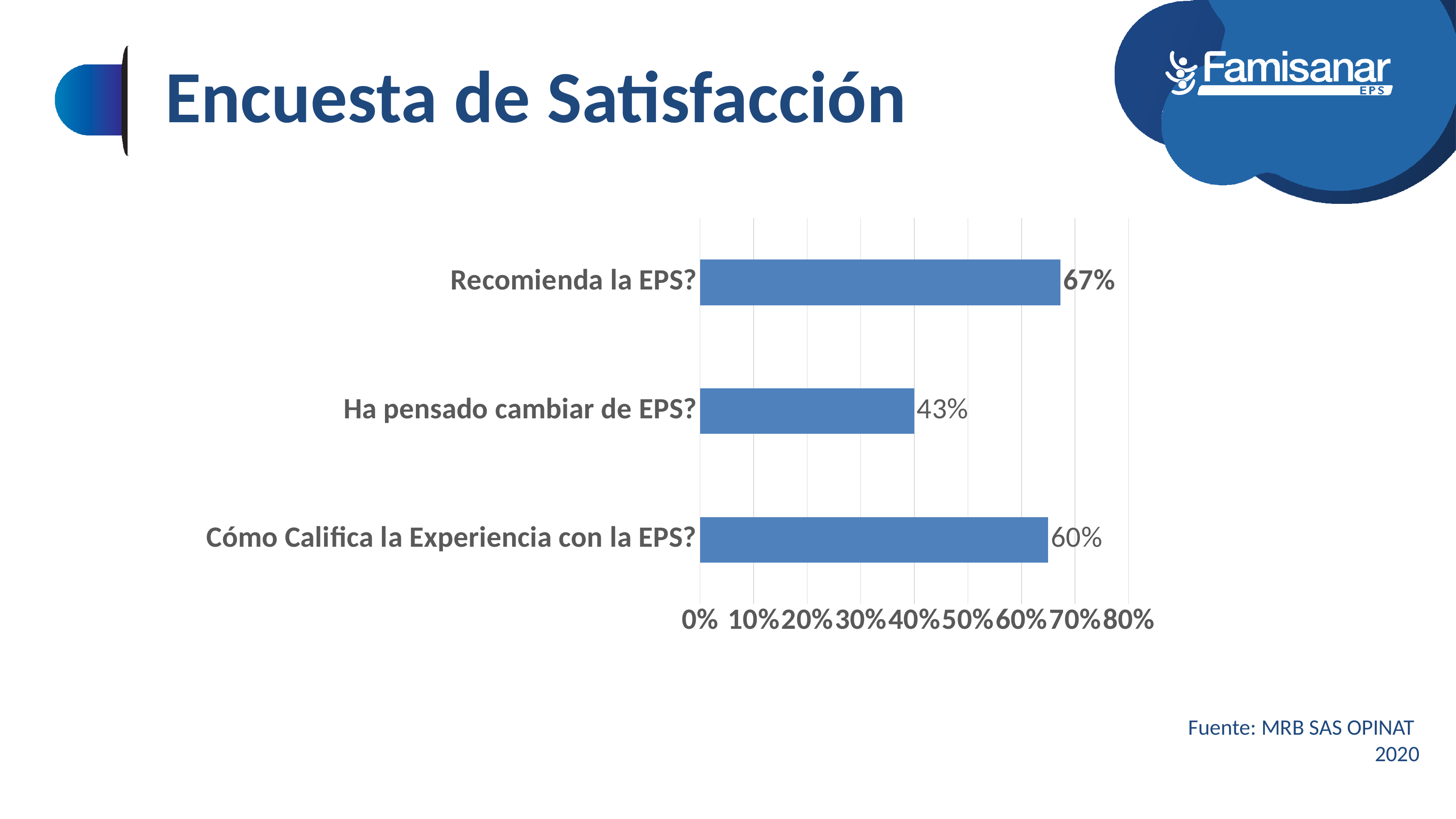
What kind of chart is shown on the slide? bar chart Is the value for "Ha pensado cambiar de EPS?" greater or less than 50%? less Which category has the lowest value? Ha pensado cambiar de EPS? What is the value for "Cómo Califica la Experiencia con la EPS?"? 60% What is the value for "Ha pensado cambiar de EPS?"? 43% What is the difference between the values for "Cómo Califica la Experiencia con la EPS?" and "Ha pensado cambiar de EPS?"? 17% Which category has the highest value? Recomienda la EPS? What is the value for "Recomienda la EPS?"? 67% What is the difference between the values for "Recomienda la EPS?" and "Ha pensado cambiar de EPS?"? 24% Which is larger, the value for "Recomienda la EPS?" or the value for "Cómo Califica la Experiencia con la EPS?"? Recomienda la EPS? How many categories are shown in the chart? 3 What is the title of the slide containing the chart? Encuesta de Satisfacción